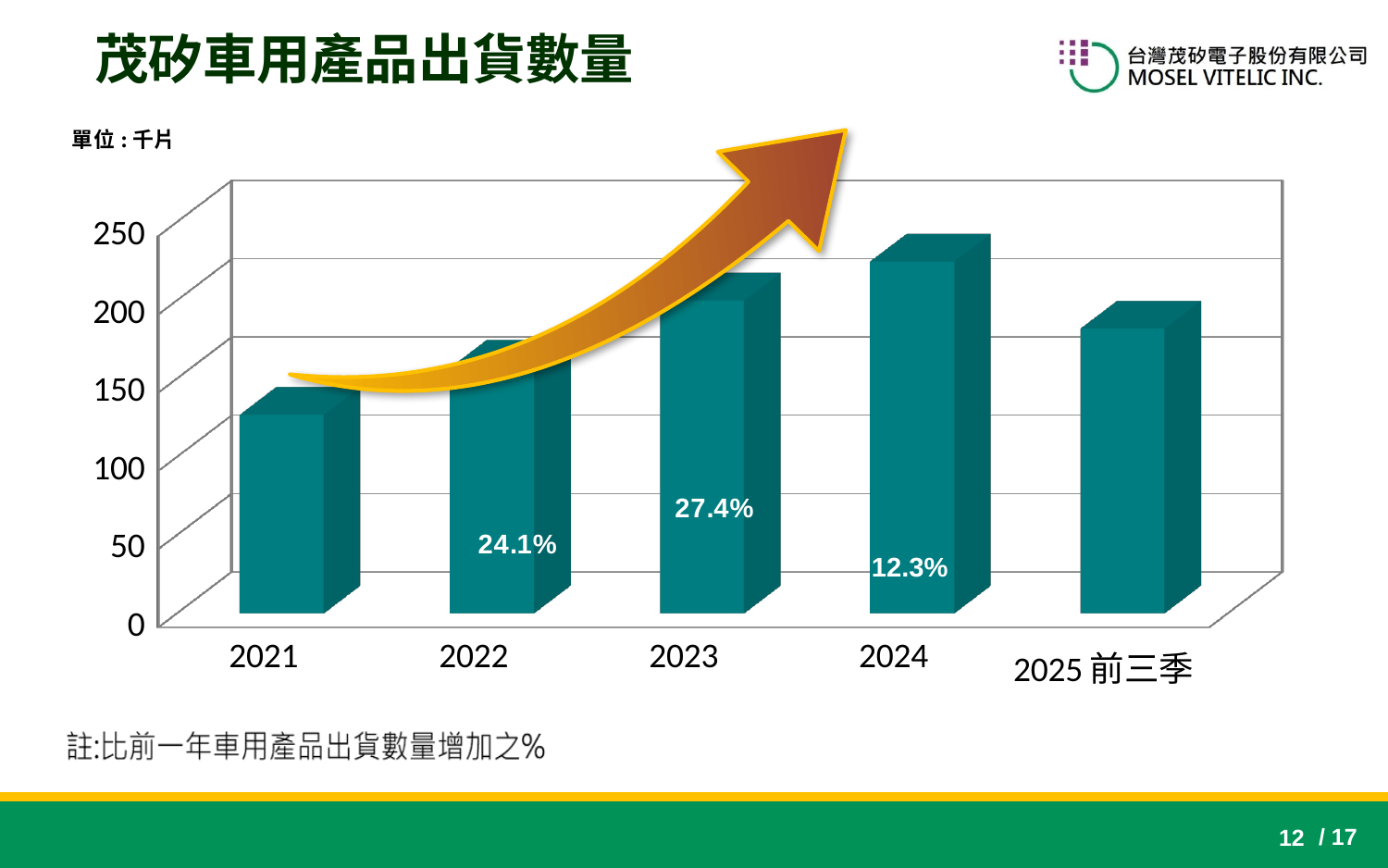
Which year has the lowest shipment volume? 2021 What growth percentage is printed on the 2024 bar? 12.3% How many categories (bars) are shown on the x axis? 5 What growth percentage is printed on the 2022 bar? 24.1% Which is larger, the value for 2024 or the value for 2025 前三季? 2024 What unit is stated for the chart values? 千片 What kind of chart is shown on the slide? bar chart What growth percentage is printed on the 2023 bar? 27.4% Is the value for 2021 greater or less than 150? less Is the value for 2024 greater or less than 200? greater Do the values rise or fall from 2021 to 2024? rise Which year has the highest shipment volume? 2024